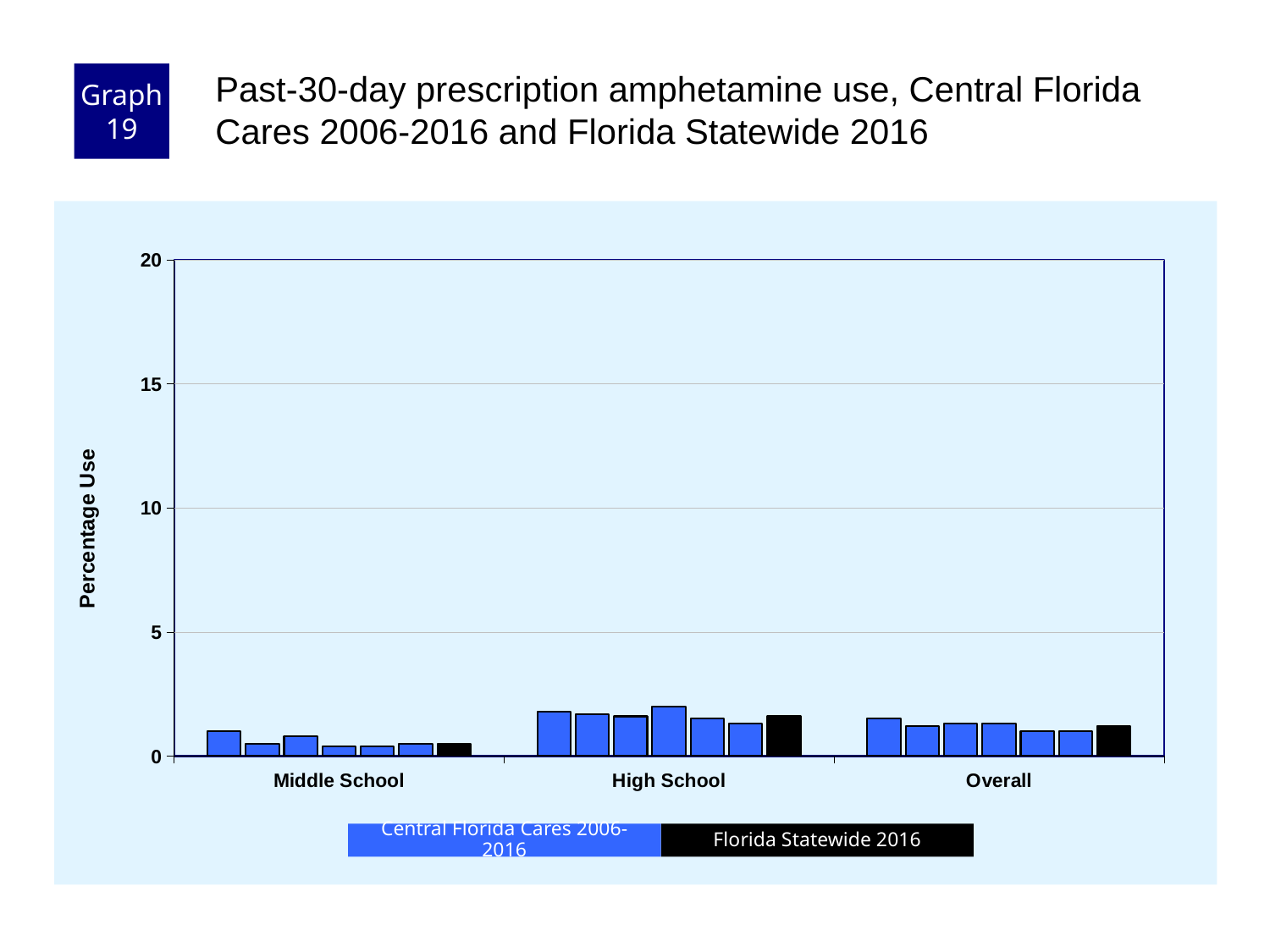
Is the Florida Statewide 2016 value for Overall greater or less than 10? less How many series does the legend list? 2 Is the Florida Statewide 2016 value larger for High School or for Middle School? High School Is the Florida Statewide 2016 value for High School greater or less than 5? less Is the Florida Statewide 2016 value for Middle School greater or less than 5? less What kind of chart is shown on the slide? bar chart What is the label on the y axis? Percentage Use Which legend entry is shown in black? Florida Statewide 2016 Which category has the lowest Florida Statewide 2016 value? Middle School Which category has the highest Florida Statewide 2016 value: Middle School, High School, or Overall? High School Is the Florida Statewide 2016 value larger for Overall or for Middle School? Overall How many school-level categories are shown on the x axis? 3